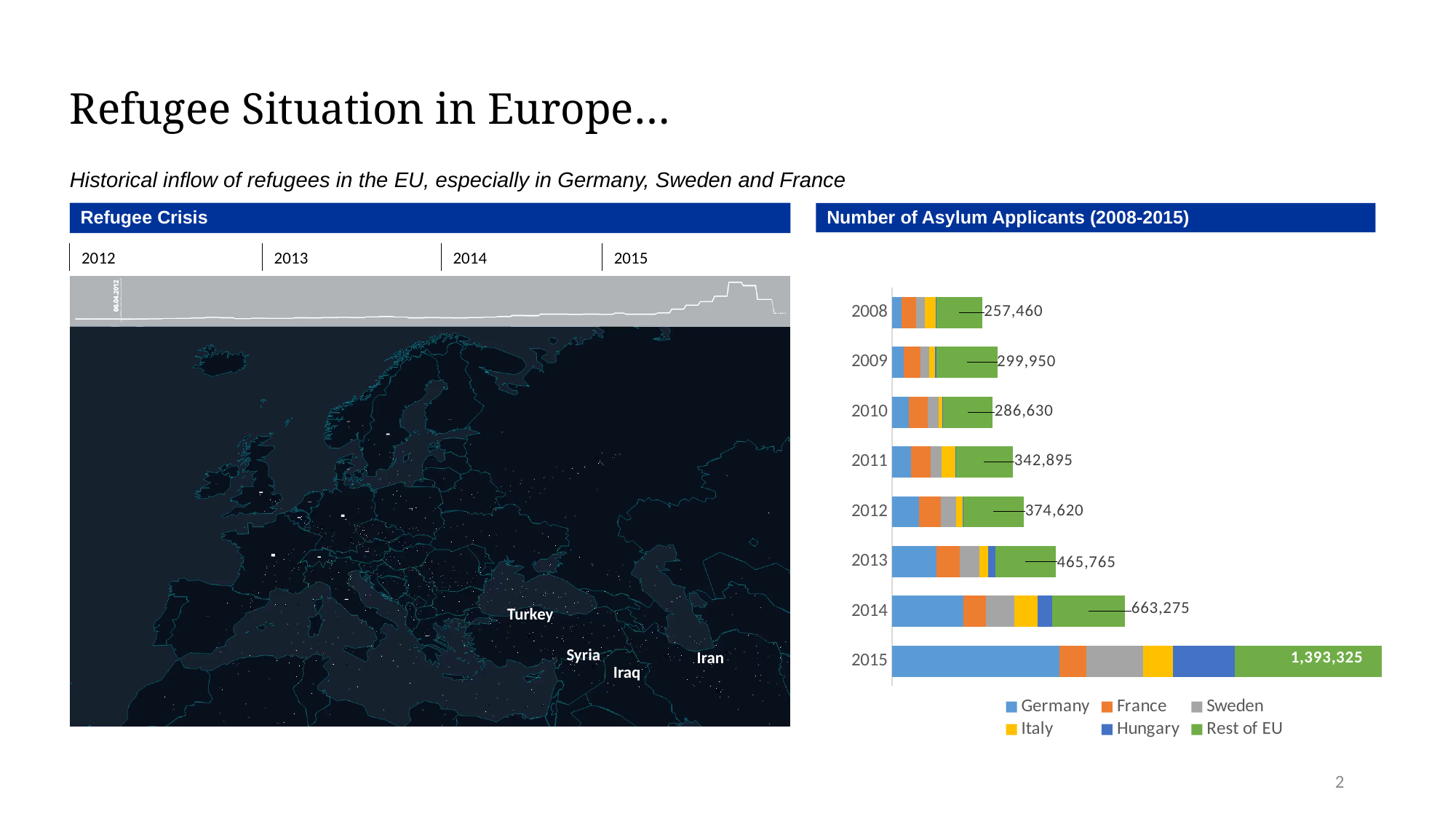
In the 'Number of Asylum Applicants (2008-2015)' chart, which year has the lowest total number of asylum applicants? 2008 How many series does the legend of the 'Number of Asylum Applicants (2008-2015)' chart list? 6 In the 'Number of Asylum Applicants (2008-2015)' chart, what is the total number of asylum applicants in 2015? 1,393,325 In the 'Number of Asylum Applicants (2008-2015)' chart, what is the difference between the totals for 2015 and 2014? 730,050 In the 'Number of Asylum Applicants (2008-2015)' chart, which colour represents Germany in the legend? Blue In the 'Number of Asylum Applicants (2008-2015)' chart, what is the difference between the totals for 2013 and 2012? 91,145 In the 'Number of Asylum Applicants (2008-2015)' chart, which year has a larger total, 2009 or 2010? 2009 How many years are shown in the 'Number of Asylum Applicants (2008-2015)' chart? 8 In the 'Number of Asylum Applicants (2008-2015)' chart, which year has the highest total number of asylum applicants? 2015 What kind of chart is the 'Number of Asylum Applicants (2008-2015)' chart? Stacked bar chart In the 'Number of Asylum Applicants (2008-2015)' chart, what is the total for 2013? 465,765 In the 'Number of Asylum Applicants (2008-2015)' chart, what is the total number of asylum applicants in 2008? 257,460